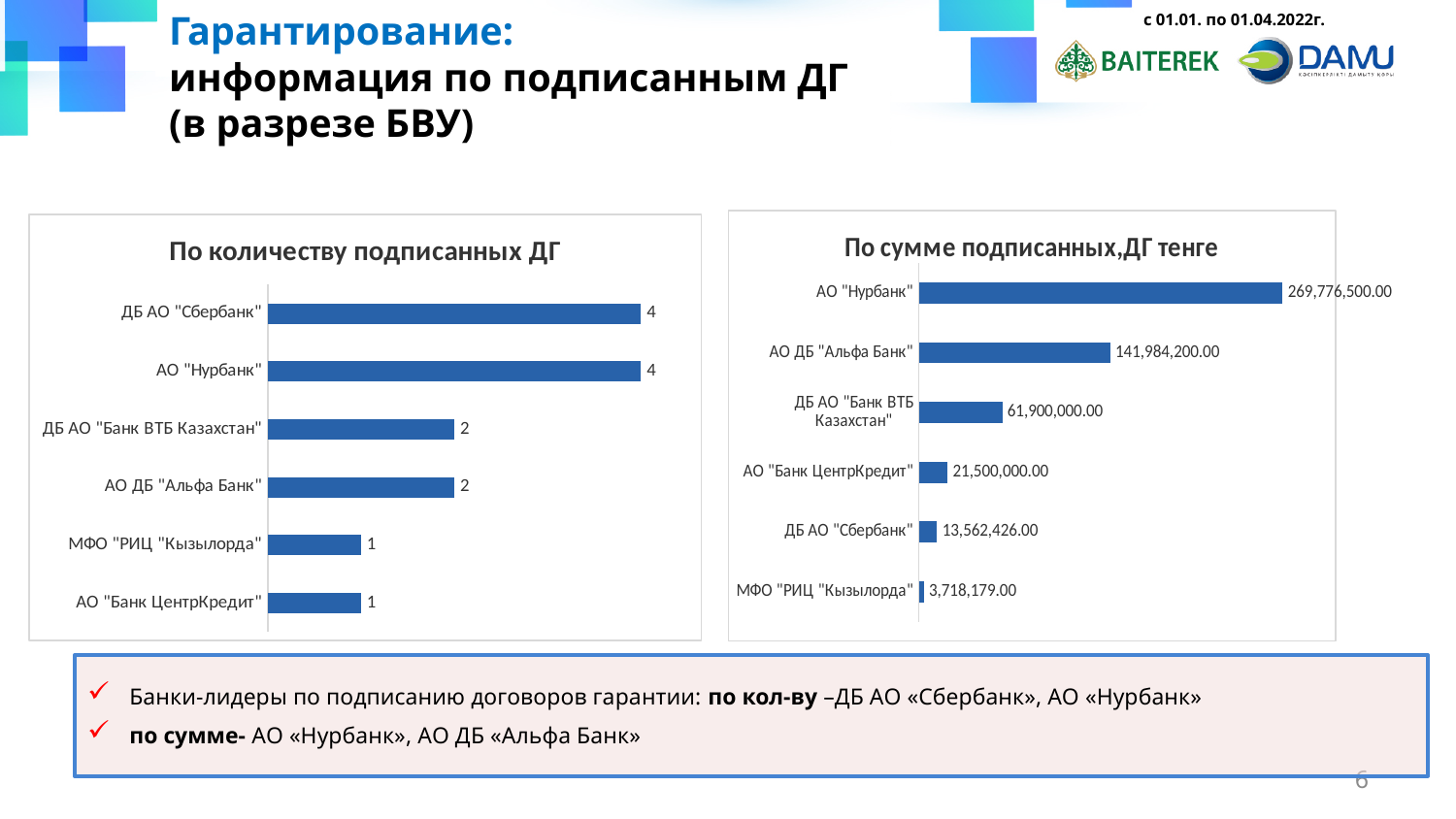
In the chart "По сумме подписанных,ДГ тенге", what is the value for ДБ АО "Сбербанк"? 13,562,426.00 In the chart "По количеству подписанных ДГ", what is the value for МФО "РИЦ "Кызылорда"? 1 In the chart "По сумме подписанных,ДГ тенге", which is larger: the value for АО ДБ "Альфа Банк" or ДБ АО "Банк ВТБ Казахстан"? АО ДБ "Альфа Банк" What type of chart is "По количеству подписанных ДГ"? Bar chart In the chart "По количеству подписанных ДГ", what is the value for ДБ АО "Банк ВТБ Казахстан"? 2 In the chart "По сумме подписанных,ДГ тенге", what is the value for АО "Нурбанк"? 269,776,500.00 In the chart "По количеству подписанных ДГ", what is the difference between the values for ДБ АО "Сбербанк" and АО ДБ "Альфа Банк"? 2 In the chart "По сумме подписанных,ДГ тенге", which category has the highest value? АО "Нурбанк" What is the title of the chart on the right side of the slide? По сумме подписанных,ДГ тенге In the chart "По количеству подписанных ДГ", how many categories are shown? 6 In the chart "По сумме подписанных,ДГ тенге", which category has the lowest value? МФО "РИЦ "Кызылорда" In the chart "По сумме подписанных,ДГ тенге", what is the difference between the values for АО "Банк ЦентрКредит" and ДБ АО "Сбербанк"? 7,937,574.00